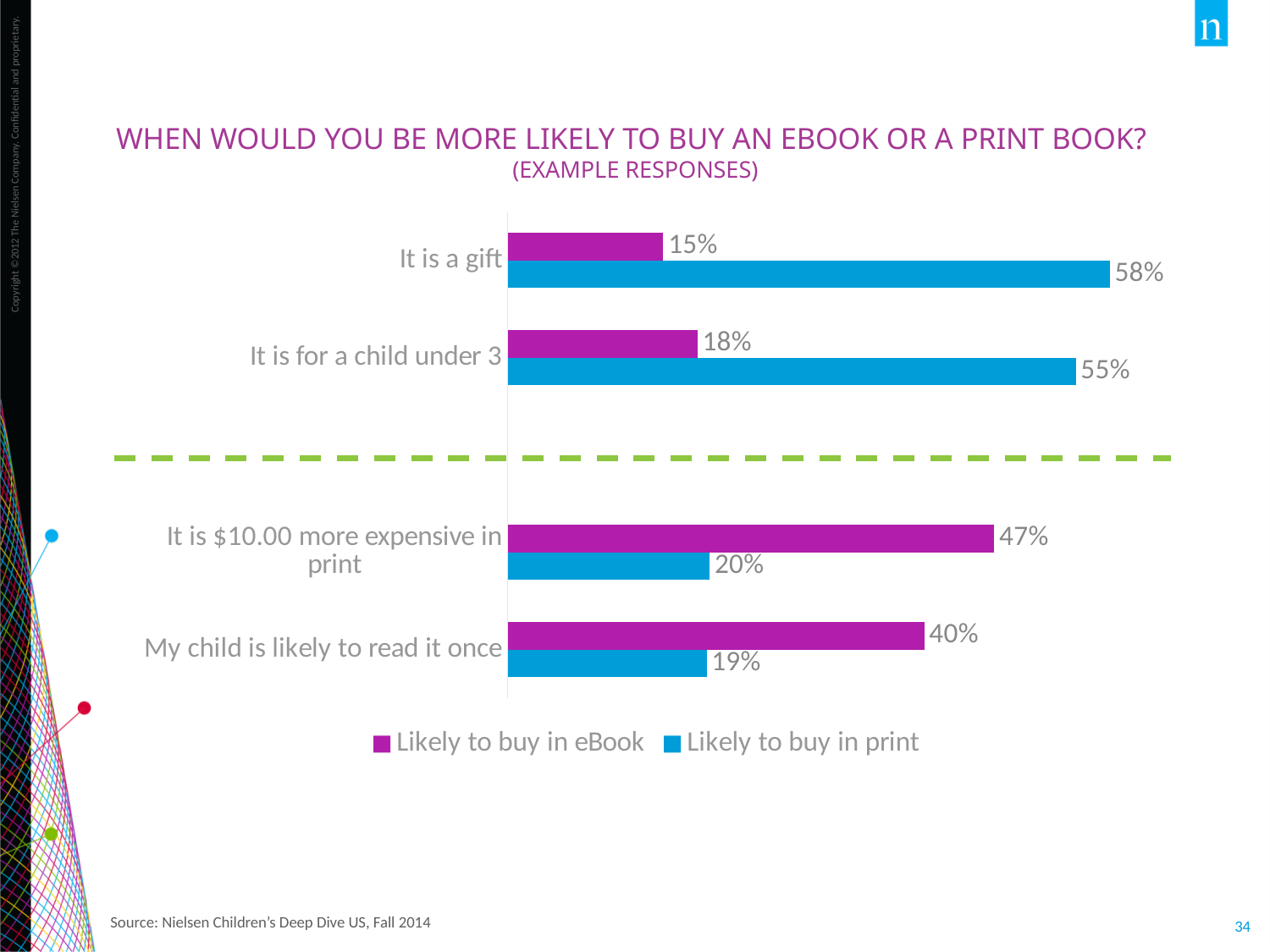
What is the difference between 'Likely to buy in print' and 'Likely to buy in eBook' for 'It is a gift'? 43 percentage points What colour represents 'Likely to buy in print' in the chart? Blue How many categories are shown in the chart? 4 What kind of chart is shown on the slide? Bar chart How many series does the legend list? 2 What is the value for 'Likely to buy in eBook' for 'It is $10.00 more expensive in print'? 47% Which category has the lowest value for 'Likely to buy in eBook'? It is a gift What is the value for 'Likely to buy in eBook' for 'It is for a child under 3'? 18% For 'My child is likely to read it once', which is larger: 'Likely to buy in eBook' or 'Likely to buy in print'? Likely to buy in eBook What is the value for 'Likely to buy in print' for 'My child is likely to read it once'? 19% What is the value for 'Likely to buy in print' for 'It is a gift'? 58% Which category has the highest value for 'Likely to buy in print'? It is a gift